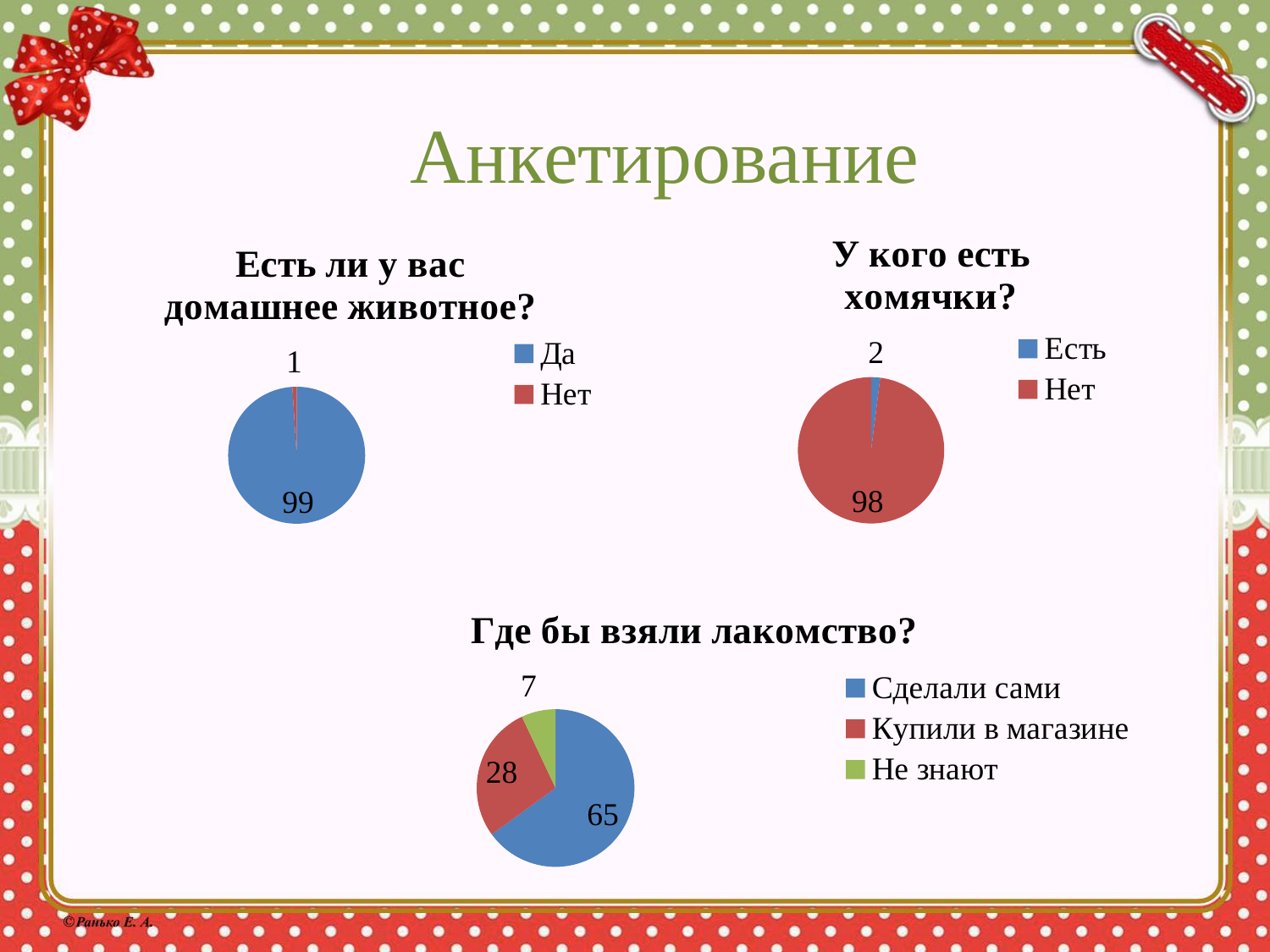
In the chart titled "У кого есть хомячки?", which category is the largest? Нет How many categories does the chart titled "Где бы взяли лакомство?" have? 3 In the chart titled "Есть ли у вас домашнее животное?", what is the value for "Нет"? 1 What kind of chart is the chart titled "Есть ли у вас домашнее животное?"? Pie chart How many series does the legend of the chart titled "У кого есть хомячки?" list? 2 In the chart titled "Где бы взяли лакомство?", which category is the smallest? Не знают In the chart titled "Где бы взяли лакомство?", what share of the pie does "Сделали сами" represent? 65% In the chart titled "Где бы взяли лакомство?", what is the value for "Купили в магазине"? 28 In the chart titled "Есть ли у вас домашнее животное?", what is the value for "Да"? 99 In the chart titled "У кого есть хомячки?", what is the difference between "Нет" and "Есть"? 96 In the chart titled "Где бы взяли лакомство?", which is larger, "Сделали сами" or "Купили в магазине"? Сделали сами In the chart titled "У кого есть хомячки?", what is the value for "Есть"? 2